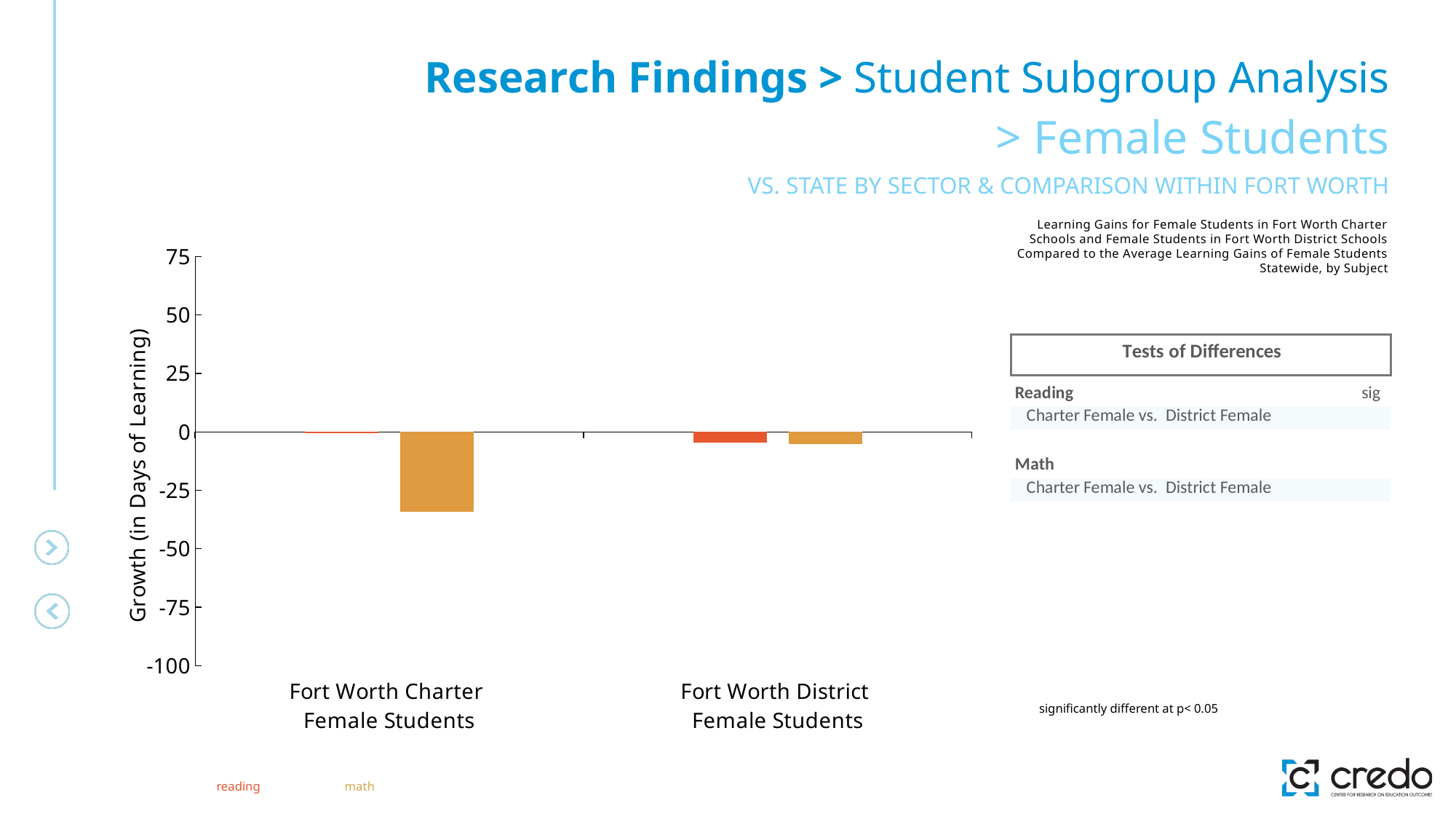
What is the label of the chart's y axis? Growth (in Days of Learning) How many categories are shown on the x axis of the chart? 2 Is the math value for Fort Worth District Female Students greater or less than -25? greater How many series does the chart's legend list? 2 What kind of chart is shown on the slide? bar chart Which series is shown in orange-gold in the chart's legend? math Which bar shows the lowest value in the chart? math for Fort Worth Charter Female Students Is the math value for Fort Worth Charter Female Students greater or less than -25? less Which is larger, the reading value for Fort Worth Charter Female Students or the reading value for Fort Worth District Female Students? Fort Worth Charter Female Students Is the math value for Fort Worth Charter Female Students greater or less than -50? greater Which is larger, the math value for Fort Worth Charter Female Students or the math value for Fort Worth District Female Students? Fort Worth District Female Students